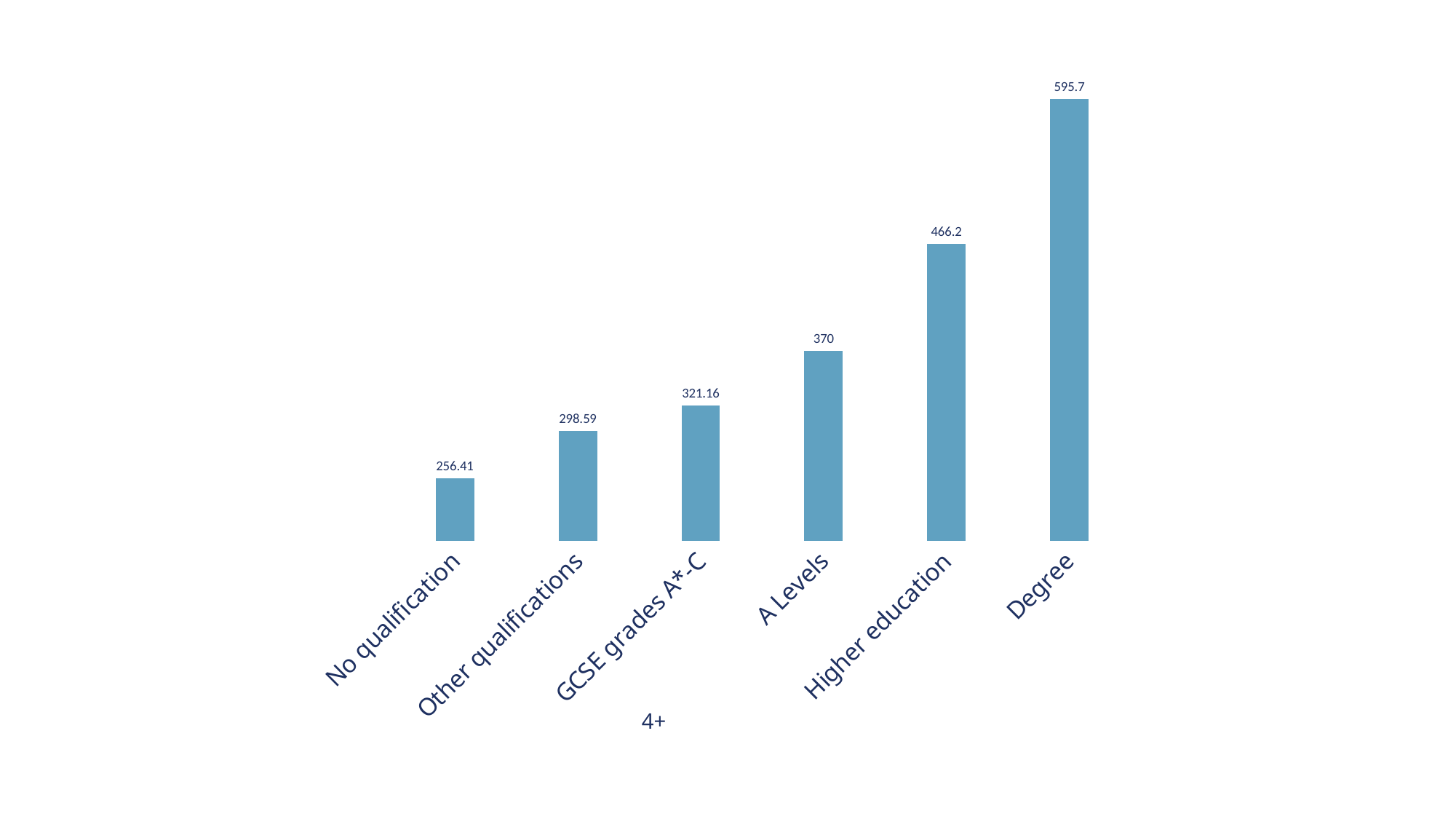
What is the difference between the values for Higher education and A Levels? 96.2 Which category has the lowest value? No qualification Which is larger, the value for Other qualifications or the value for GCSE grades A*-C? GCSE grades A*-C What is the value for GCSE grades A*-C? 321.16 What is the difference between the values for Degree and No qualification? 339.29 What kind of chart is shown on the slide? Bar chart Which category has the highest value? Degree What is the value for Degree? 595.7 Do the values rise or fall from left to right along the x axis? Rise What is the value for No qualification? 256.41 How many categories are shown on the chart? 6 What is the value for A Levels? 370